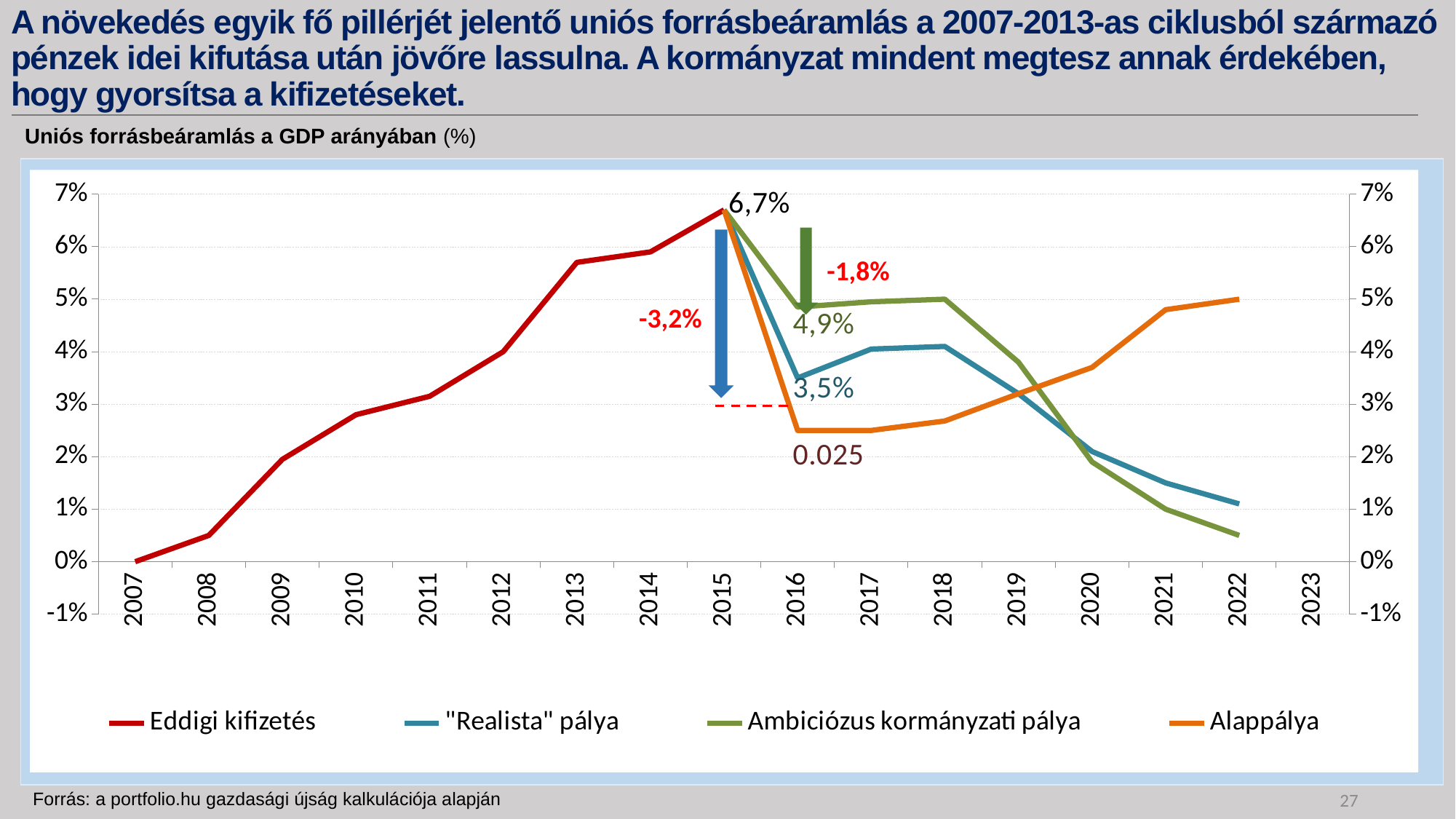
What is the difference between the 2015 peak of 6,7% and the 2016 value of the Ambiciózus kormányzati pálya series? 1,8% What is the value of the "Realista" pálya series in 2016? 3,5% What kind of chart is shown on the slide? line chart Does the Eddigi kifizetés series rise or fall from 2007 to 2015? rise What is the value of the Ambiciózus kormányzati pálya series in 2016? 4,9% How many series does the legend list? 4 What is the difference between the 2015 peak of 6,7% and the 2016 value of the "Realista" pálya series? 3,2% Which series has the highest value in 2022? Alappálya What is the value of the Eddigi kifizetés series in 2015? 6,7% Is the value of the Alappálya series in 2022 greater or less than 4%? greater In 2016, which is larger: the "Realista" pálya value or the Ambiciózus kormányzati pálya value? Ambiciózus kormányzati pálya What colour is the Alappálya line in the legend? orange